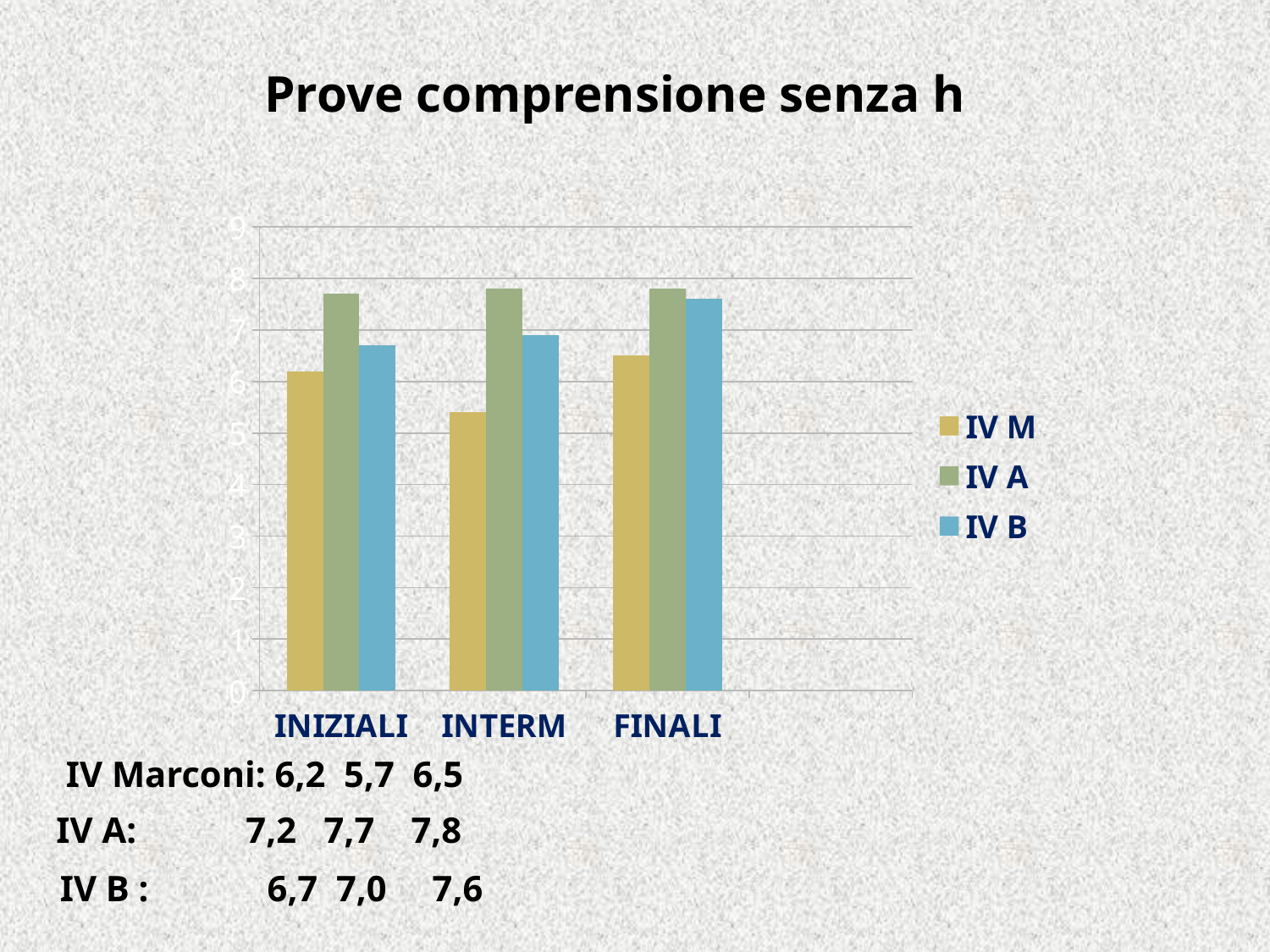
What is the value for IV B in the FINALI category? 7,6 In the INIZIALI category, which is larger: IV B or IV M? IV B Is the value for IV M in the INTERM category greater or less than 6? less What is the difference between the IV A and IV M values in the FINALI category? 1,3 What is the value for IV M in the INIZIALI category? 6,2 Which series has the highest value in the FINALI category? IV A What kind of chart is shown on the slide? bar chart Do the IV B values rise or fall from INIZIALI to FINALI? rise How many categories are shown on the x axis of the chart? 3 How many series does the chart legend list? 3 In which category does IV M have its lowest value? INTERM What is the value for IV A in the FINALI category? 7,8